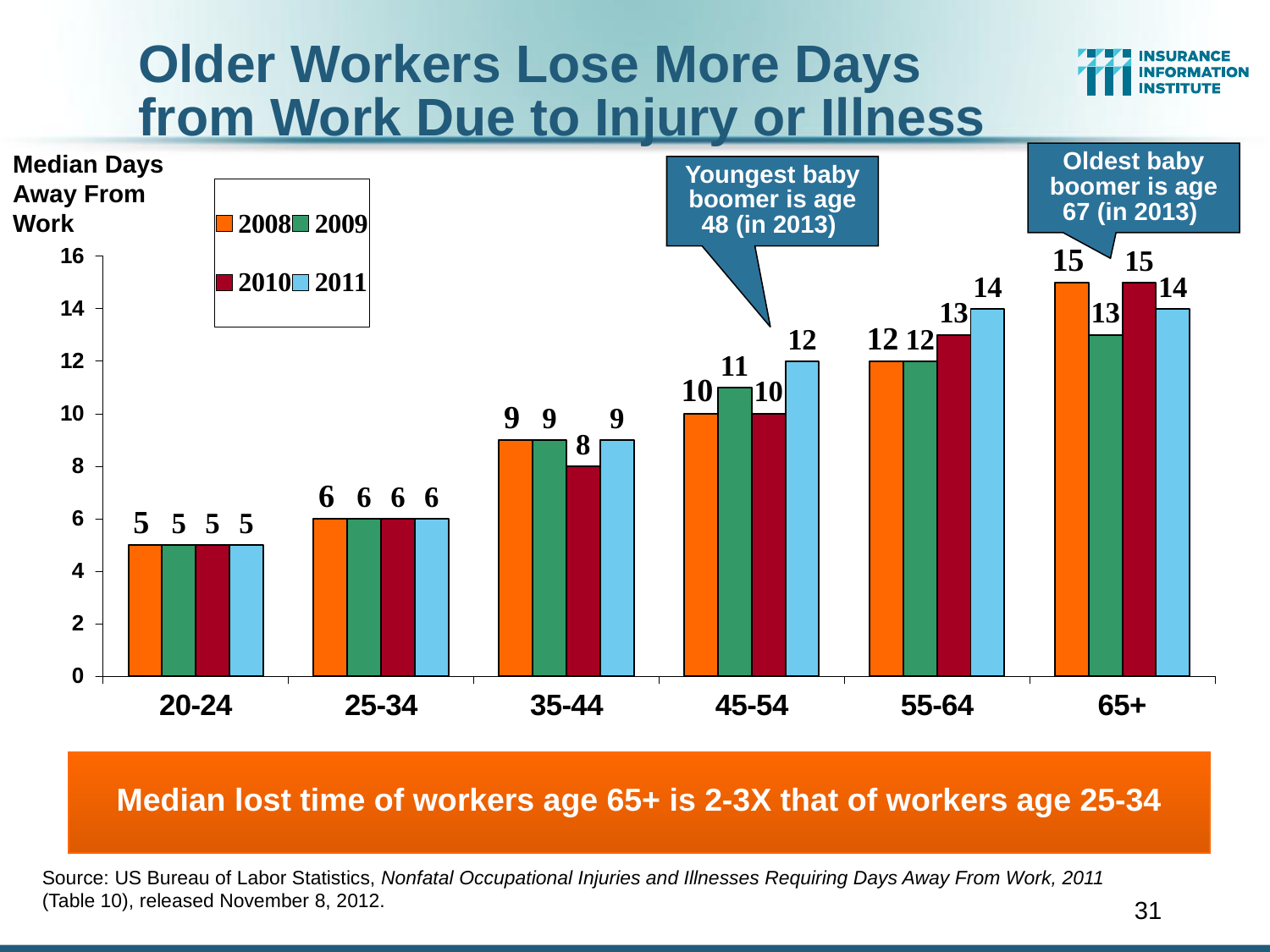
What is the difference between the 2011 values for the 55-64 and 25-34 age groups? 8 Which year is represented by the orange bars in the legend? 2008 What is the median days away from work for the 35-44 age group in 2010? 8 Which age group has the highest median days away from work in 2008? 65+ How many age groups are shown on the x axis? 6 Which age group has the lowest median days away from work in 2011? 20-24 Do the 2008 values generally rise or fall as age group increases along the x axis? rise What is the median days away from work for the 45-54 age group in 2011? 12 Which is larger, the 2009 value for 45-54 or the 2009 value for 65+? 65+ What is the median days away from work for the 65+ age group in 2009? 13 What kind of chart is shown on the slide? bar chart How many series does the legend list? 4